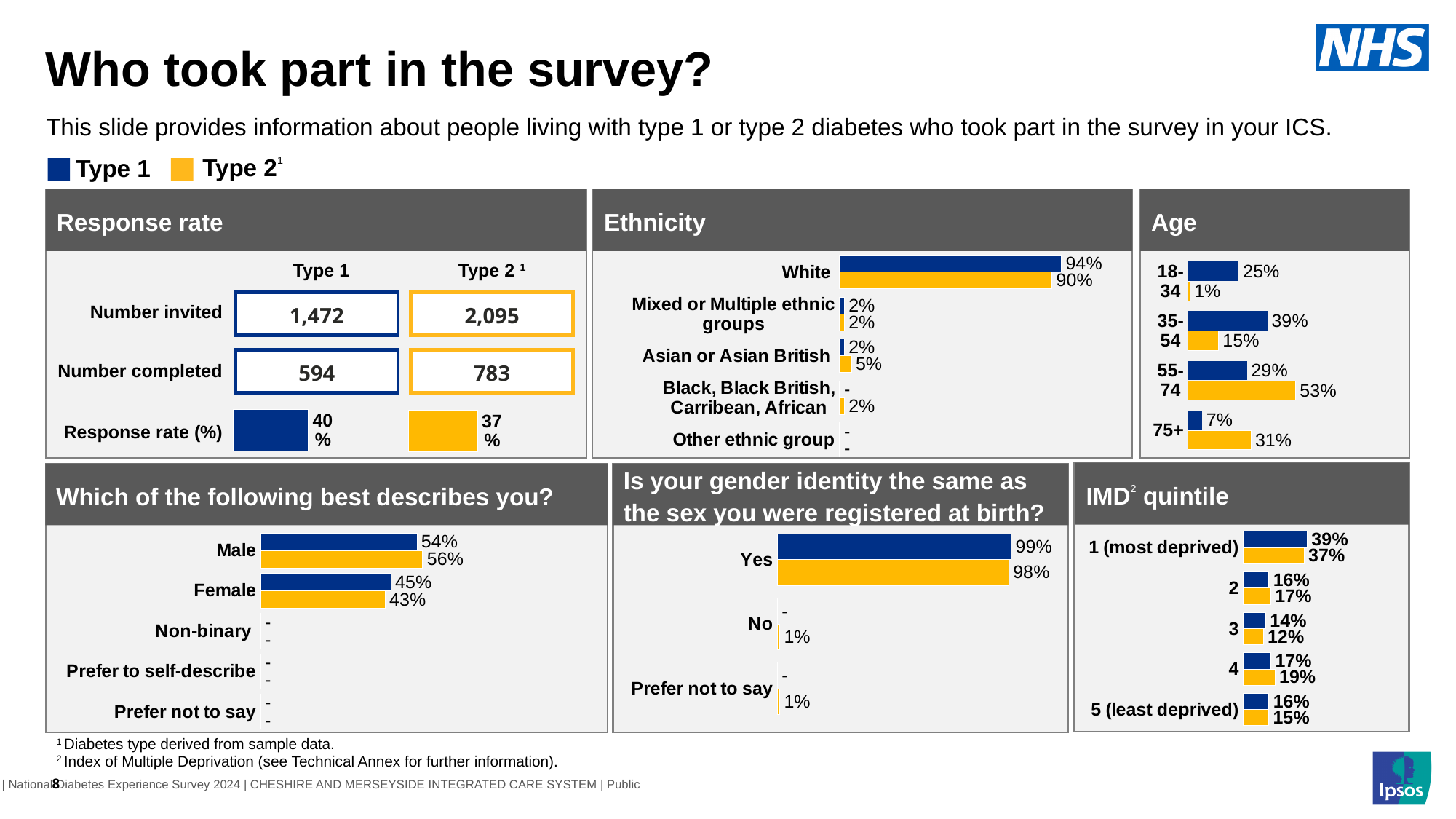
In the Age chart, what is the Type 2 value for the 55-74 age group? 53% In the IMD quintile chart, which quintile has the highest Type 2 percentage? 1 (most deprived) How many series does the legend at the top of the slide list? 2 In the Response rate panel, what is the difference between the number of Type 2 and Type 1 respondents who completed the survey? 189 In the Age chart, what is the difference between the Type 2 and Type 1 values for the 75+ age group? 24 percentage points In the 'Which of the following best describes you?' chart, is the Type 1 or Type 2 value larger for Male? Type 2 In the Response rate panel, how many Type 2 people were invited? 2,095 In the gender identity chart, what percentage of Type 2 respondents answered Yes? 98% In the Ethnicity chart, what percentage of Type 1 respondents are White? 94% In the Age chart, which age group has the highest Type 1 percentage? 35-54 In the IMD quintile chart, what is the Type 1 value for quintile 1 (most deprived)? 39% In the Age chart, which age group has the lowest Type 2 percentage? 18-34